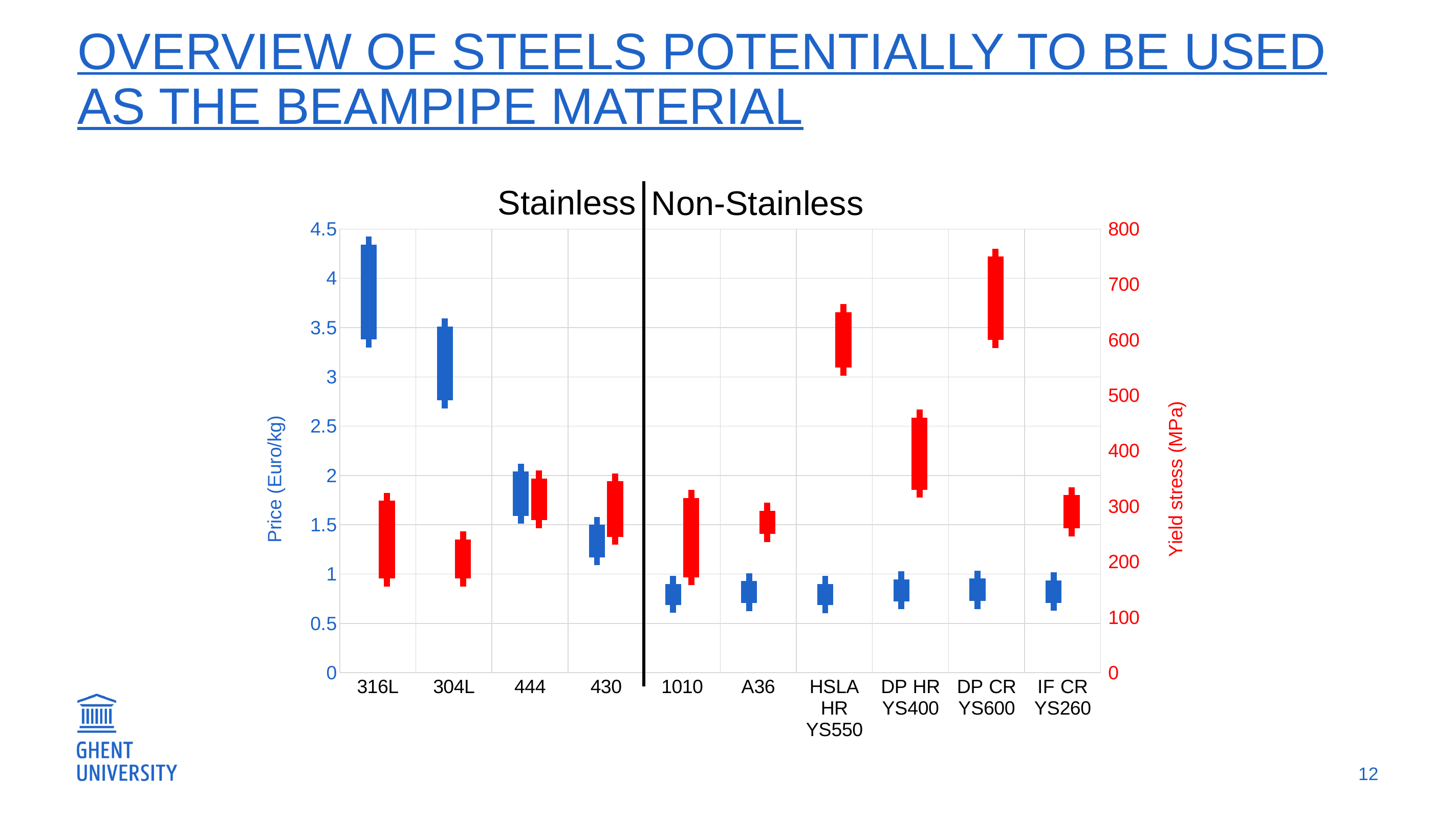
Which steel grade has the highest price (Euro/kg) in the chart? 316L Which has the higher price (Euro/kg), 316L or 304L? 316L Is the price (Euro/kg) for 444 greater or less than 2.5? less Is the yield stress (MPa) for HSLA HR YS550 greater or less than 500? greater How many steel grades are shown along the x axis of the chart? 10 What is the label of the right-hand vertical axis of the chart? Yield stress (MPa) Which steel grade has the highest yield stress (MPa) in the chart? DP CR YS600 Which has the higher yield stress (MPa), DP CR YS600 or DP HR YS400? DP CR YS600 Is the yield stress (MPa) for A36 greater or less than 400? less How many steel grades are in the Stainless group of the chart? 4